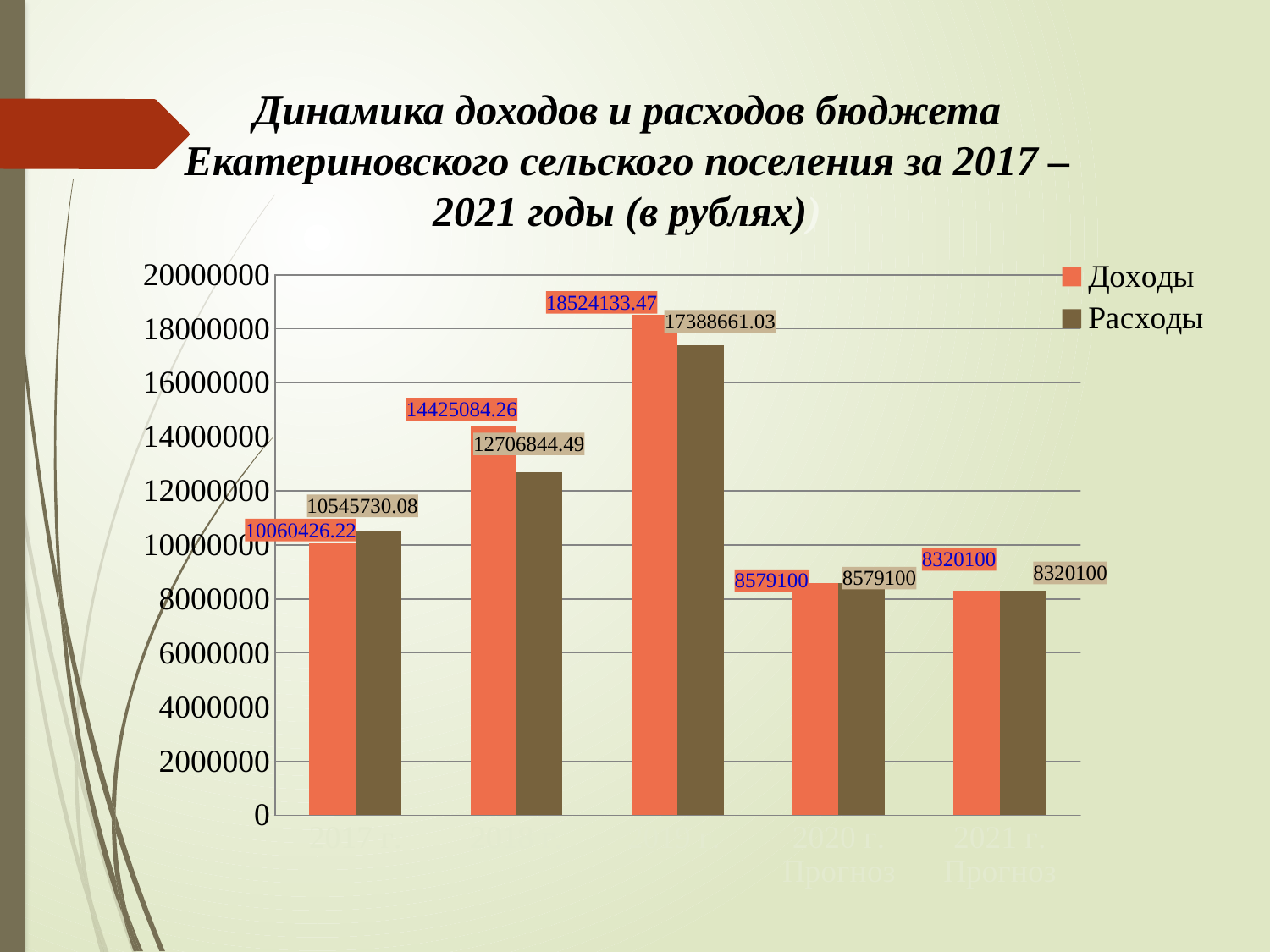
In which year are Доходы the highest? 2019 How many years (categories) are shown on the x axis? 5 Is the value of Расходы for 2019 greater or less than 16000000? greater What is the value of Расходы for 2018? 12706844.49 What is the value of Доходы for 2019? 18524133.47 What is the difference between Доходы and Расходы in 2018? 1718239.77 In 2017, which is larger: Доходы or Расходы? Расходы Do Доходы rise or fall from 2017 to 2019? rise How many series does the legend list? 2 In which year are Расходы the lowest? 2021 What is the difference between Доходы and Расходы in 2019? 1135472.44 What kind of chart is shown on the slide? bar chart